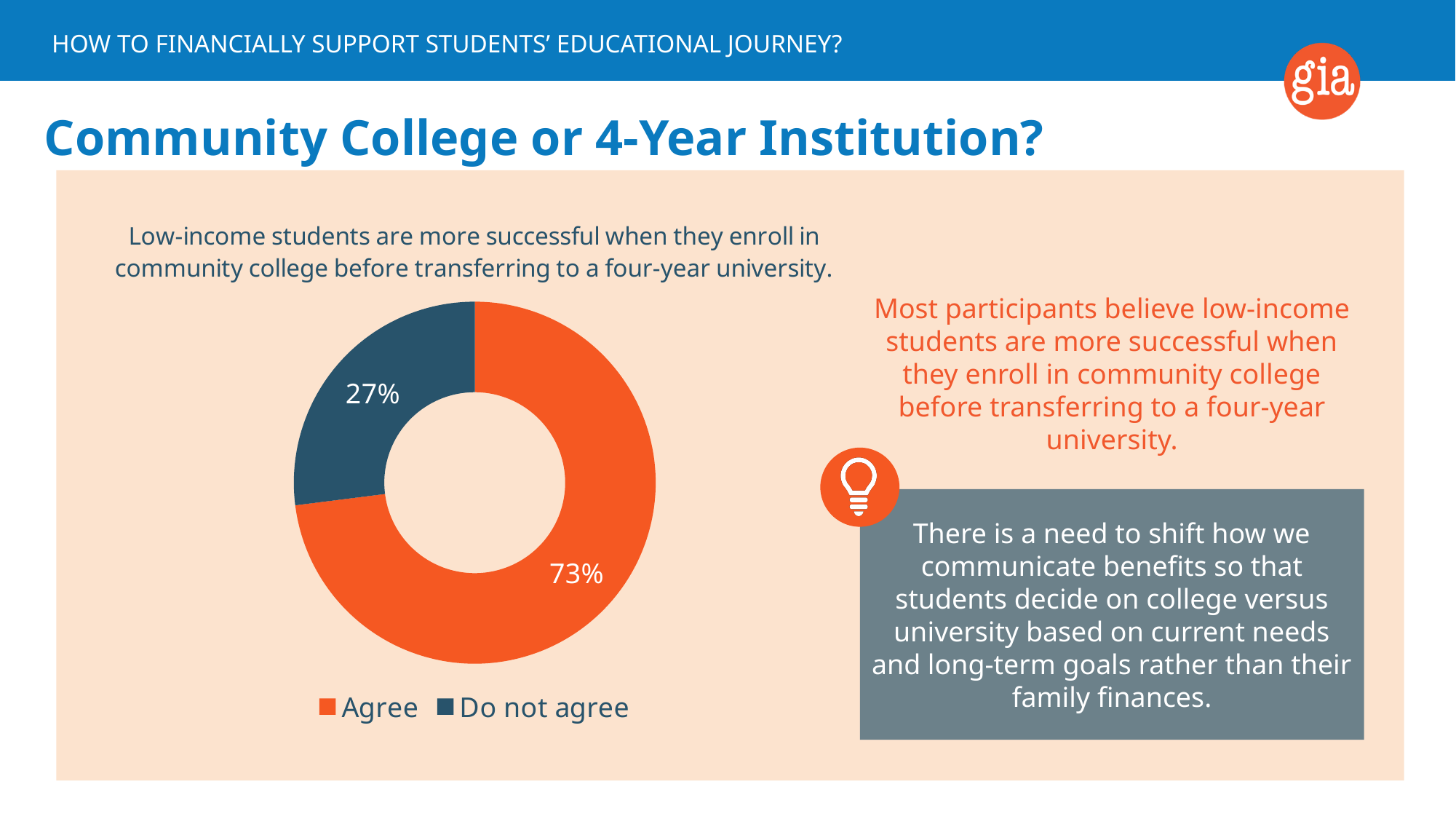
How many categories does the chart show? 2 What is the title of the chart? Low-income students are more successful when they enroll in community college before transferring to a four-year university. How many entries does the chart legend list? 2 Which category has the largest share of the chart? Agree What percentage of participants agree that low-income students are more successful when they enroll in community college before transferring to a four-year university? 73% Which is larger, the share for Agree or the share for Do not agree? Agree What colour represents the Agree category in the chart? Orange Is the share for Do not agree greater or less than 50%? less Which category has the smallest share of the chart? Do not agree What percentage of participants do not agree with the statement in the chart? 27% What is the difference in percentage points between Agree and Do not agree? 46 What kind of chart is shown on the slide? Pie chart (donut)